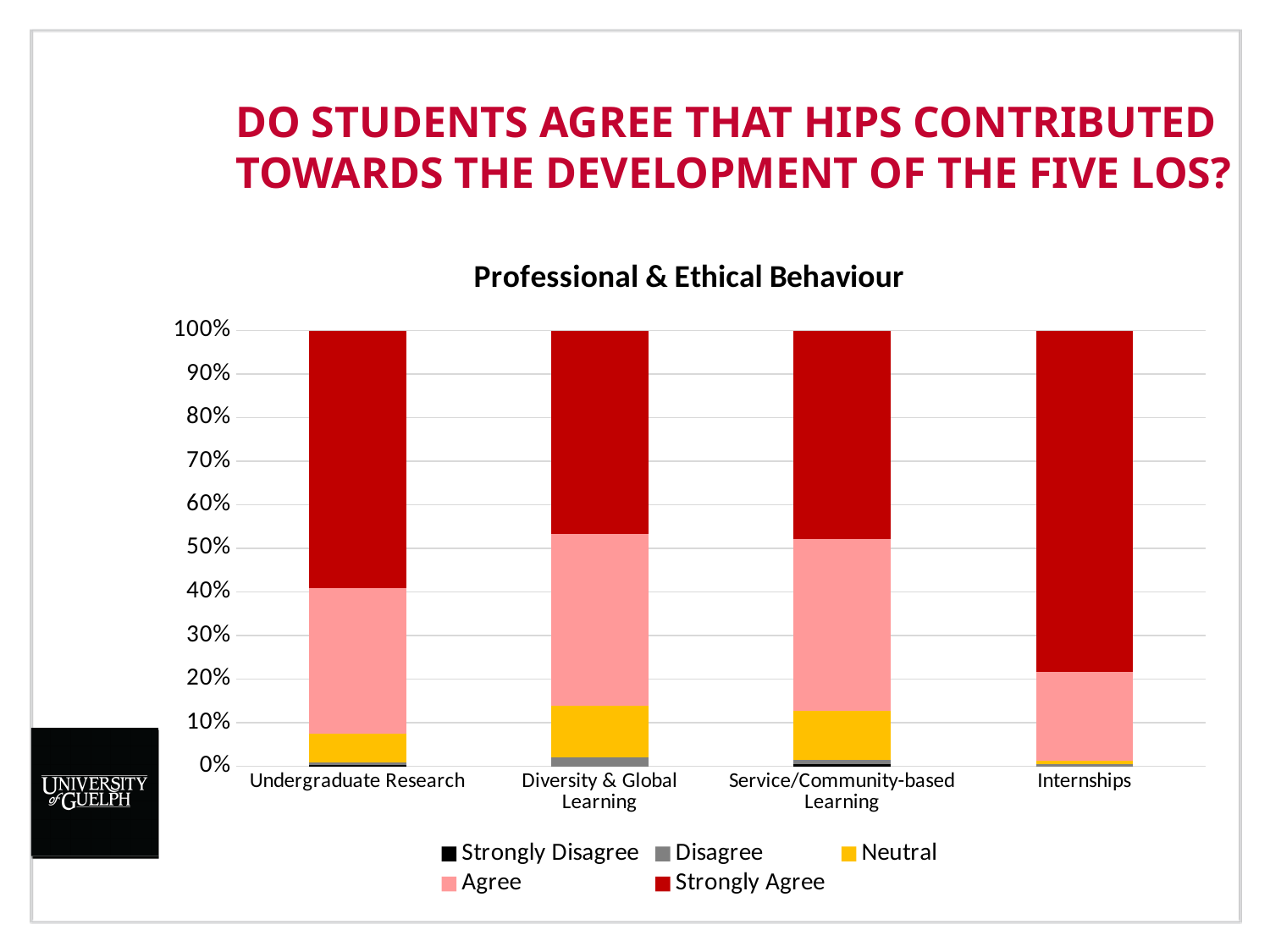
What is the title of the chart? Professional & Ethical Behaviour Which category has the smallest Neutral segment? Internships Is the Agree share for Internships greater or less than 30%? less How many series does the chart's legend list? 5 Is the Strongly Agree share for Undergraduate Research greater or less than 50%? greater What kind of chart is shown on the slide? Stacked bar chart Is the Strongly Agree share for Internships greater or less than 70%? greater What is the total height of the stacked bar for Internships? 100% Which has a larger Agree segment, Undergraduate Research or Internships? Undergraduate Research How many categories (HIPs) are shown on the x axis of the chart? 4 Which category has the smallest Agree segment? Internships Which category has the largest Strongly Agree segment? Internships